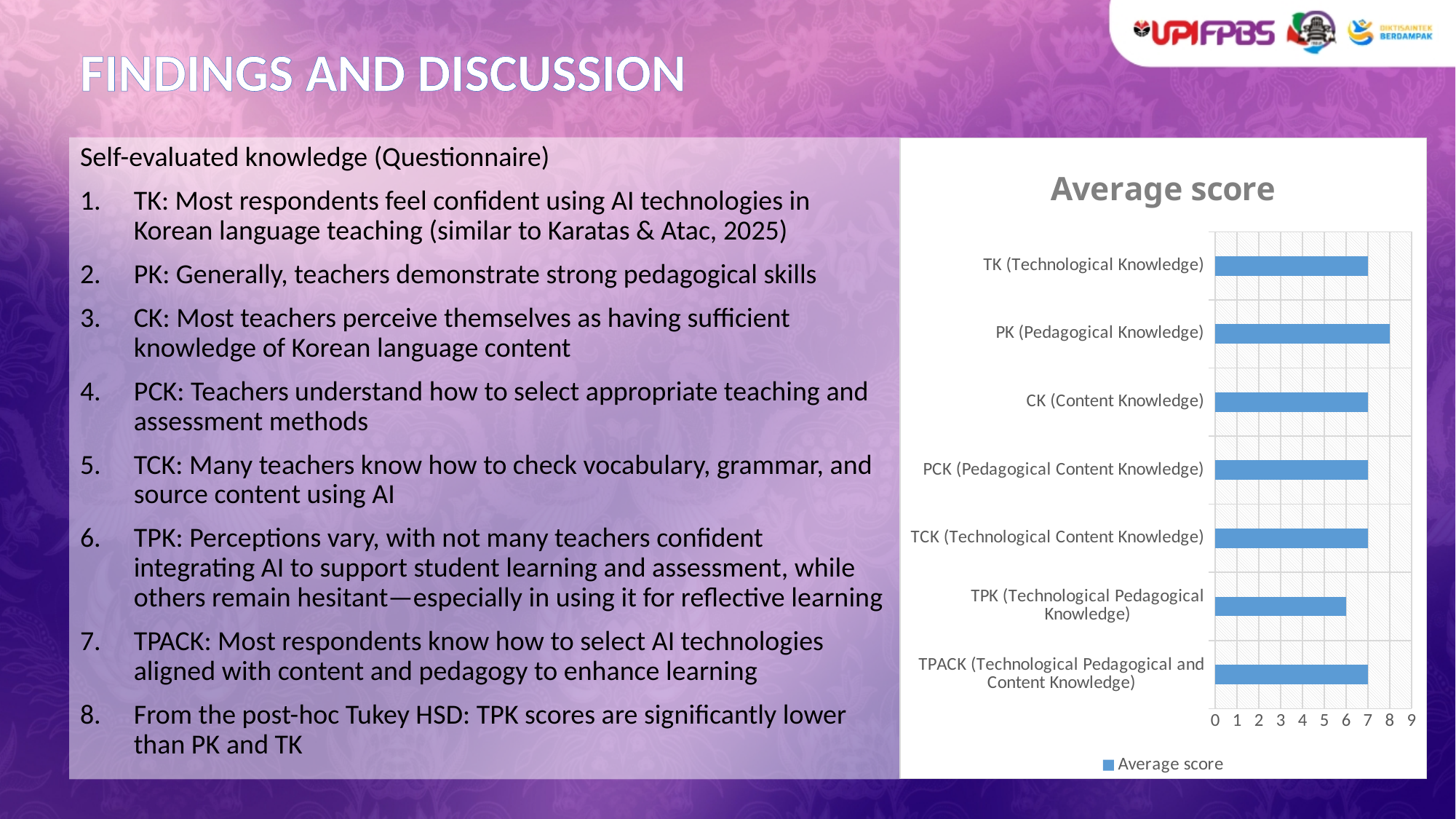
Is the value for TPK (Technological Pedagogical Knowledge) greater or less than 7? less How many categories are plotted in the chart? 7 Which category has the highest average score? PK (Pedagogical Knowledge) Is the value for TPACK (Technological Pedagogical and Content Knowledge) greater or less than 8? less Which has a larger average score, PK (Pedagogical Knowledge) or TPK (Technological Pedagogical Knowledge)? PK (Pedagogical Knowledge) What kind of chart is shown on the slide? bar chart What is the name of the series shown in the chart legend? Average score Is the value for PK (Pedagogical Knowledge) greater or less than 7? greater What is the title of the chart? Average score How many series does the chart legend list? 1 Which category has the lowest average score? TPK (Technological Pedagogical Knowledge)